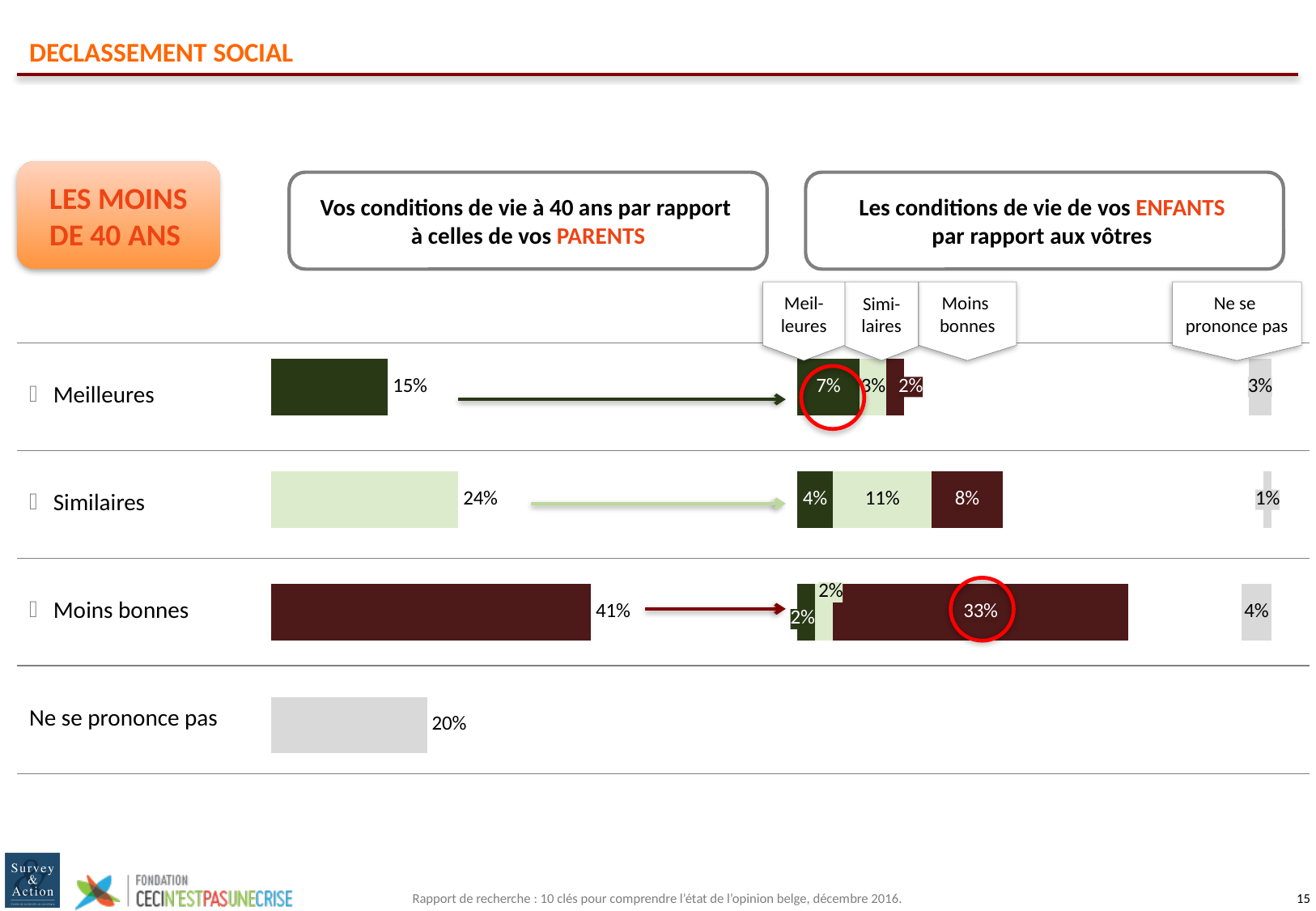
In the chart 'Les conditions de vie de vos ENFANTS par rapport aux vôtres', what is the total of the stacked bar in the 'Similaires' row (excluding 'Ne se prononce pas')? 23% In the chart 'Vos conditions de vie à 40 ans par rapport à celles de vos PARENTS', what is the difference between 'Moins bonnes' and 'Meilleures'? 26% In the chart 'Les conditions de vie de vos ENFANTS par rapport aux vôtres', what is the 'Ne se prononce pas' value in the 'Moins bonnes' row? 4% In the chart 'Vos conditions de vie à 40 ans par rapport à celles de vos PARENTS', which category has the lowest value? Meilleures In the chart 'Vos conditions de vie à 40 ans par rapport à celles de vos PARENTS', how many categories are shown? 4 In the chart 'Les conditions de vie de vos ENFANTS par rapport aux vôtres', what is the 'Similaires' value in the 'Similaires' row? 11% What kind of chart is used for 'Vos conditions de vie à 40 ans par rapport à celles de vos PARENTS'? Bar chart In the chart 'Vos conditions de vie à 40 ans par rapport à celles de vos PARENTS', what is the value for 'Moins bonnes'? 41% In the chart 'Vos conditions de vie à 40 ans par rapport à celles de vos PARENTS', what is the value for 'Similaires'? 24% In the chart 'Les conditions de vie de vos ENFANTS par rapport aux vôtres', which is larger in the 'Meilleures' row: 'Meilleures' or 'Moins bonnes'? Meilleures In the chart 'Vos conditions de vie à 40 ans par rapport à celles de vos PARENTS', which category has the highest value? Moins bonnes In the chart 'Les conditions de vie de vos ENFANTS par rapport aux vôtres', what is the 'Moins bonnes' value in the 'Moins bonnes' row? 33%